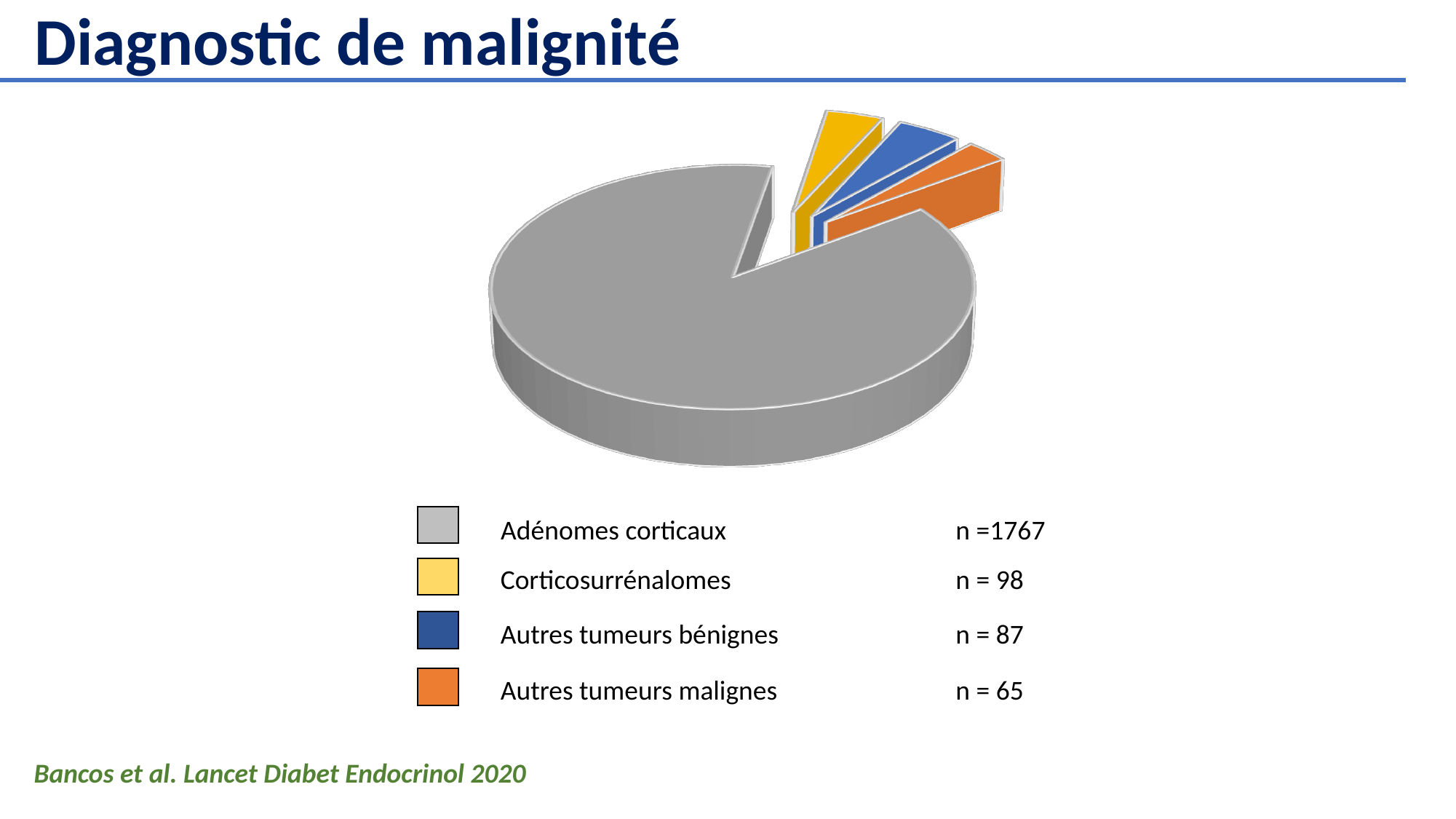
What is the value (n) for Autres tumeurs bénignes in the pie chart? 87 How many categories are shown in the pie chart? 4 Which category has the largest slice of the pie chart? Adénomes corticaux Which category has the smallest slice of the pie chart? Autres tumeurs malignes What is the difference between the n for Corticosurrénalomes and the n for Autres tumeurs malignes? 33 What colour is the slice for Adénomes corticaux? Grey What kind of chart is shown on the slide? Pie chart What is the value (n) for Adénomes corticaux in the pie chart? 1767 What is the difference between the n for Corticosurrénalomes and the n for Autres tumeurs bénignes? 11 What is the value (n) for Corticosurrénalomes in the pie chart? 98 What is the value (n) for Autres tumeurs malignes in the pie chart? 65 Which is larger: the n for Autres tumeurs bénignes or the n for Autres tumeurs malignes? Autres tumeurs bénignes